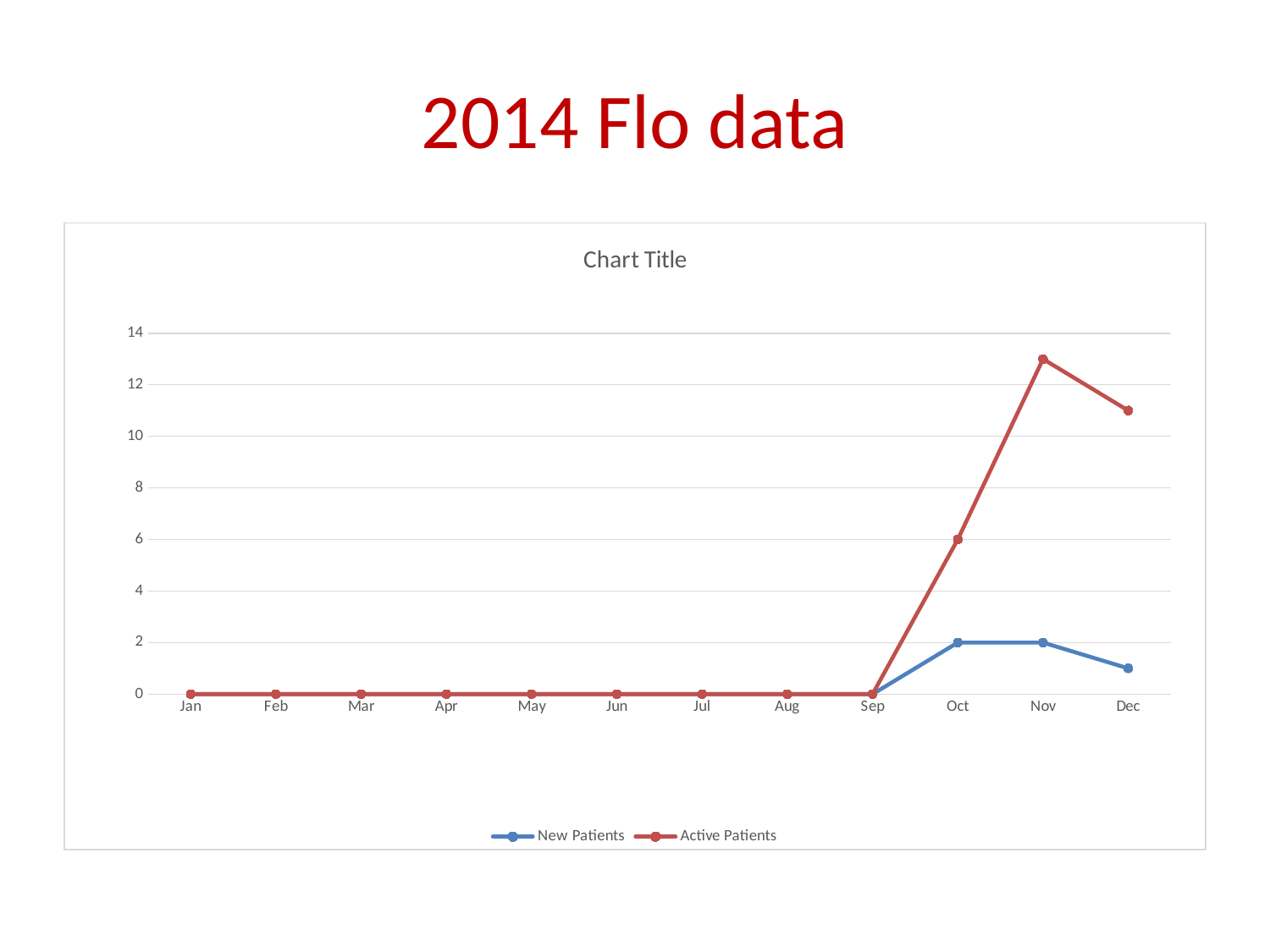
How many months are plotted along the x axis? 12 What kind of chart is shown on the slide? line chart How many series does the legend list? 2 What is the value for New Patients in Oct? 2 What is the value for Active Patients in May? 0 Is the value for New Patients in Dec greater or less than 2? less Which series has the larger value in Nov, New Patients or Active Patients? Active Patients In which month is the Active Patients value highest? Nov Does the Active Patients line rise or fall from Nov to Dec? fall